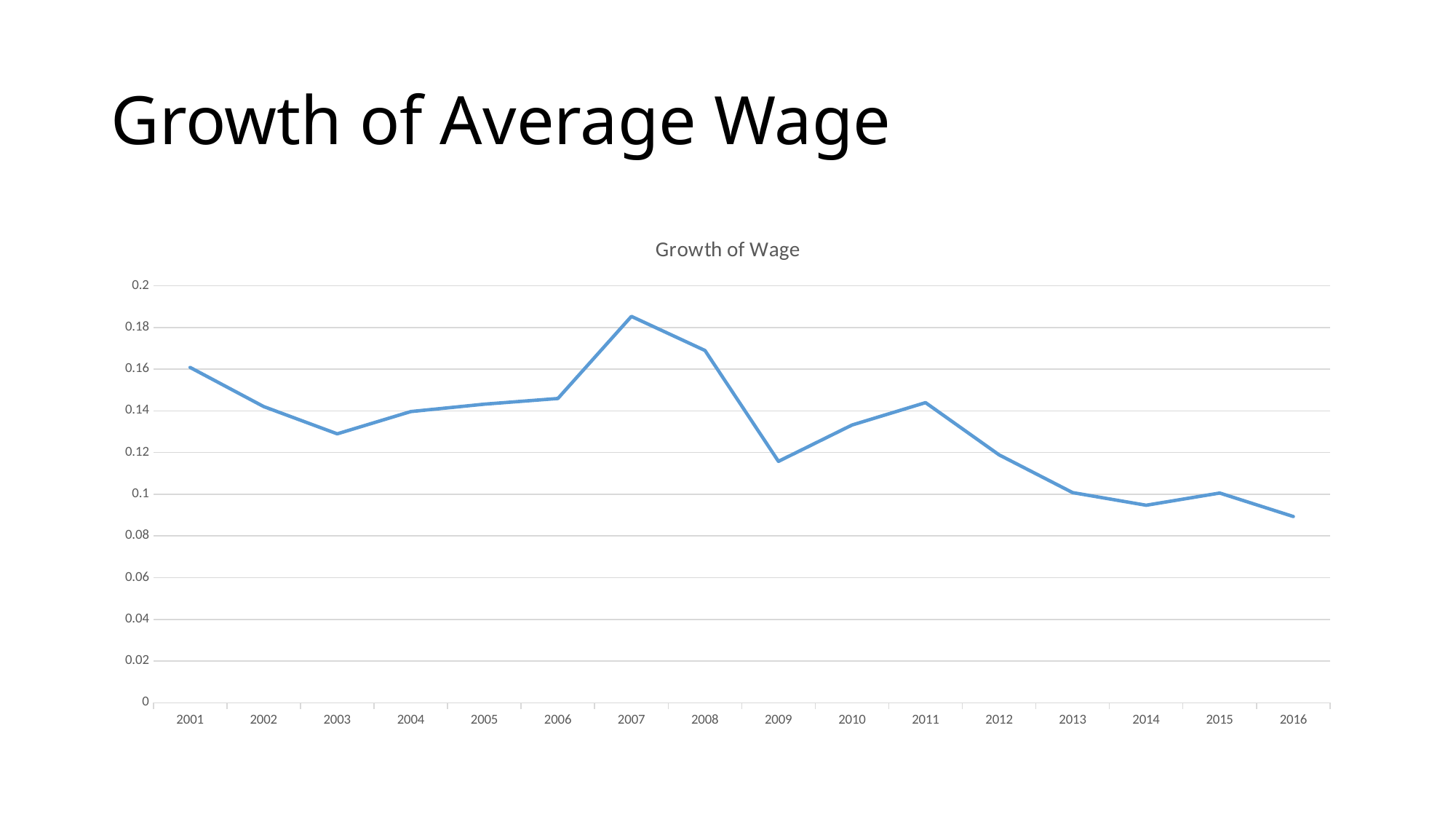
What kind of chart is shown on the slide? Line chart Is the value for 2009 greater or less than 0.12? less Is the value for 2016 greater or less than 0.1? less Overall, does the growth of wage rise or fall from 2001 to 2016? Fall How many years are plotted on the x axis? 16 What is the title of the chart? Growth of Wage Which year has a higher value, 2001 or 2016? 2001 Is the value for 2007 greater or less than 0.18? greater Which year has the lowest growth of wage? 2016 Which year has a higher value, 2007 or 2008? 2007 Which year has the highest growth of wage? 2007